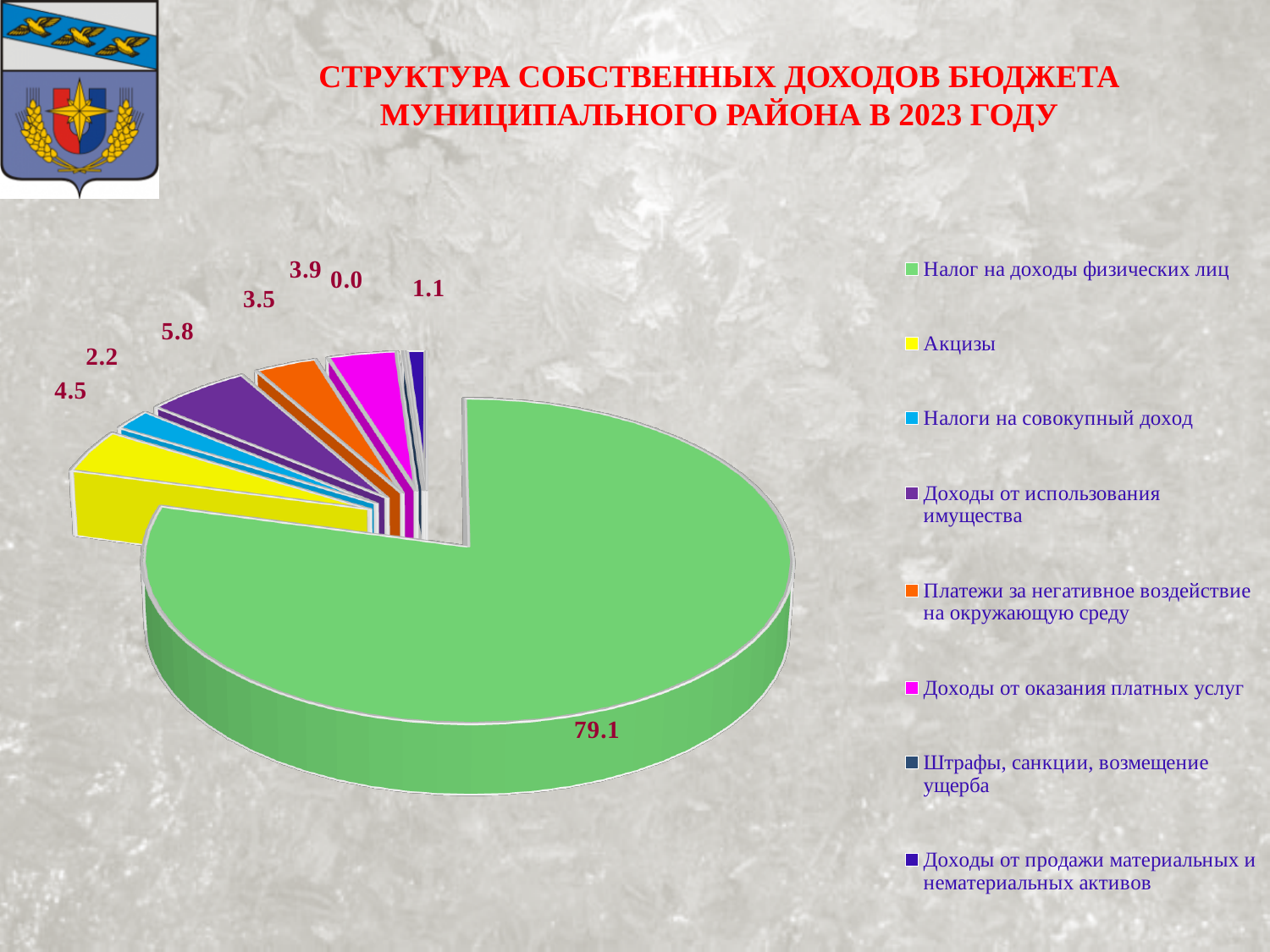
Which category has the smallest value in the pie chart? Штрафы, санкции, возмещение ущерба Which is larger: the value for Доходы от использования имущества or the value for Акцизы? Доходы от использования имущества What is the value shown for Акцизы? 4.5 What is the difference between the values for Налог на доходы физических лиц and Акцизы? 74.6 What is the value shown for Штрафы, санкции, возмещение ущерба? 0.0 How many categories does the legend list? 8 What is the value shown for Доходы от использования имущества? 5.8 What kind of chart is shown on the slide? pie chart What is the value shown for Налог на доходы физических лиц? 79.1 What is the title of the chart on the slide? СТРУКТУРА СОБСТВЕННЫХ ДОХОДОВ БЮДЖЕТА МУНИЦИПАЛЬНОГО РАЙОНА В 2023 ГОДУ What is the value shown for Налоги на совокупный доход? 2.2 Which category has the largest slice of the pie? Налог на доходы физических лиц